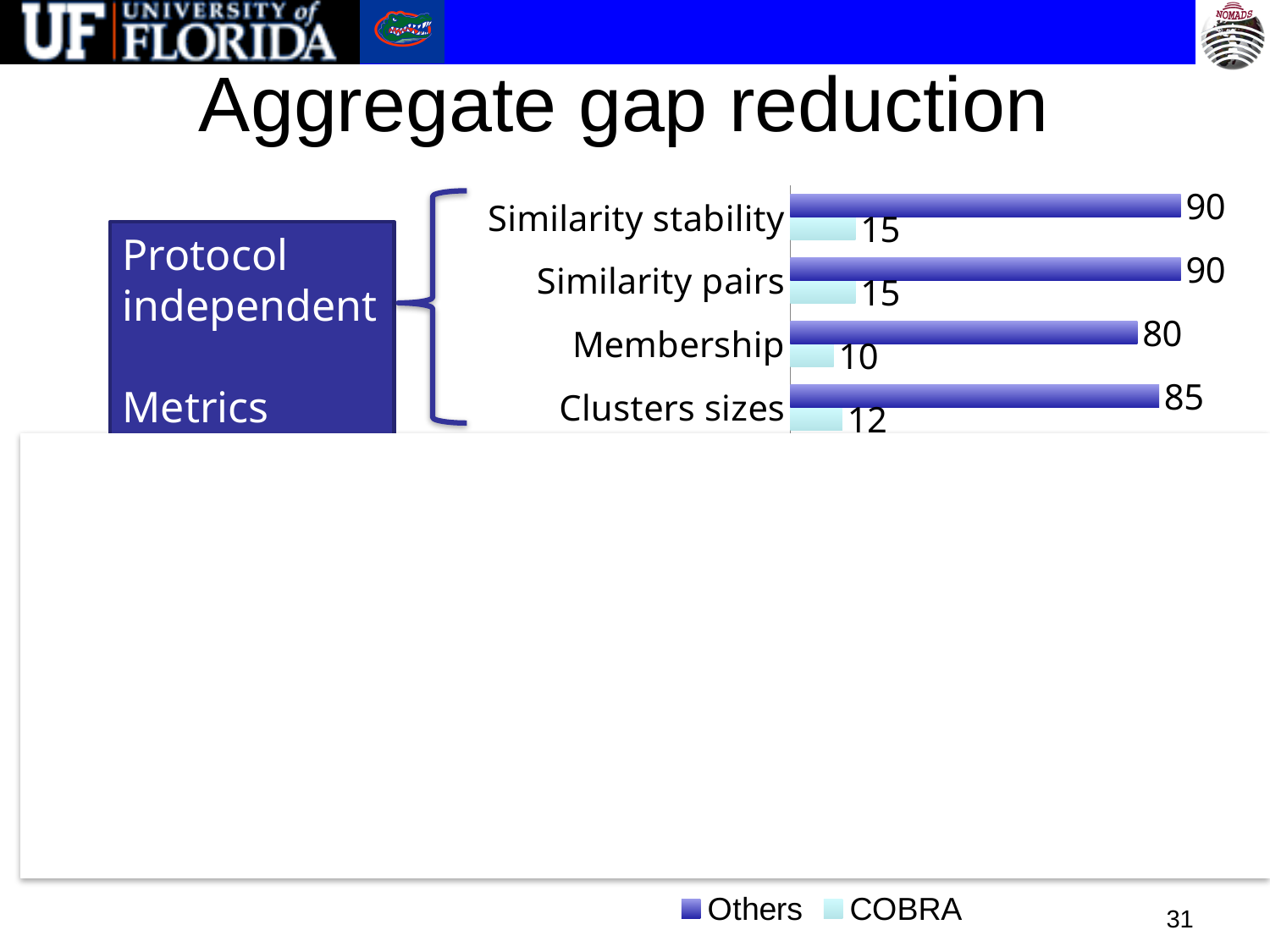
Which category has the lowest value for Others? Membership What is the difference between the Others and COBRA values for Clusters sizes? 73 What is the title of the slide containing the chart? Aggregate gap reduction What is the value for COBRA for Clusters sizes? 12 How many series does the legend list? 2 Which category has the lowest value for COBRA? Membership What is the value for Others for Membership? 80 What is the value for Others for Similarity stability? 90 What is the difference between the Others values for Similarity pairs and Membership? 10 Which is larger for Similarity pairs, the Others value or the COBRA value? Others What kind of chart is shown on the slide? Bar chart What is the value for COBRA for Membership? 10